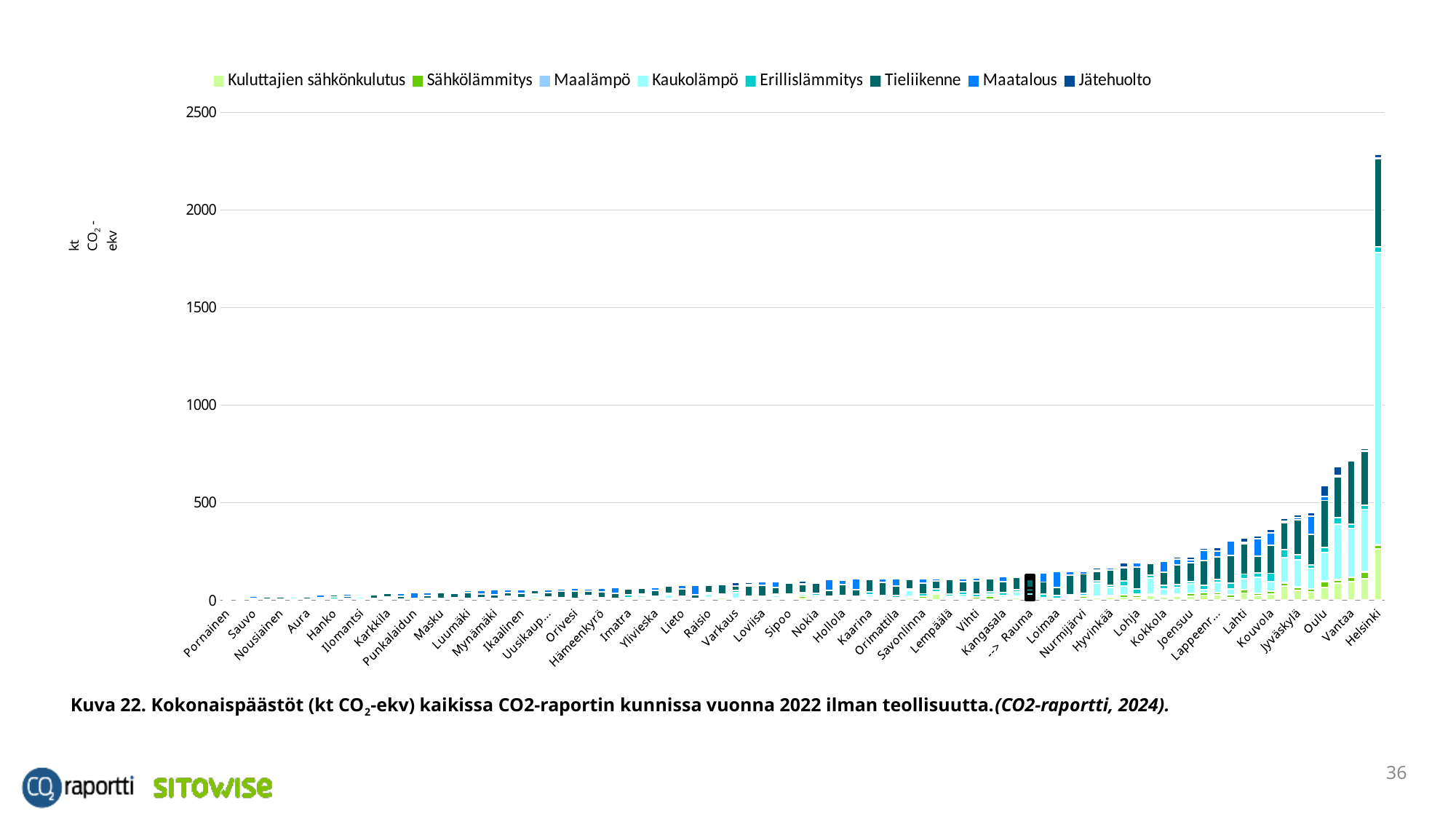
Which has a larger total, Helsinki or Vantaa? Helsinki Which municipality has the highest total emissions in the chart? Helsinki What kind of chart is shown on the slide? Stacked bar chart Is the total value for Vantaa greater or less than 1000? less Do the bar totals generally rise or fall from left to right along the x axis? Rise Is the total value for Oulu greater or less than 500? greater Is the total value for Lahti greater or less than 500? less Which has a larger total, Oulu or Lahti? Oulu How many series does the legend list? 8 What is the first entry in the chart's legend? Kuluttajien sähkönkulutus What unit is shown on the y-axis label of the chart? kt CO2-ekv